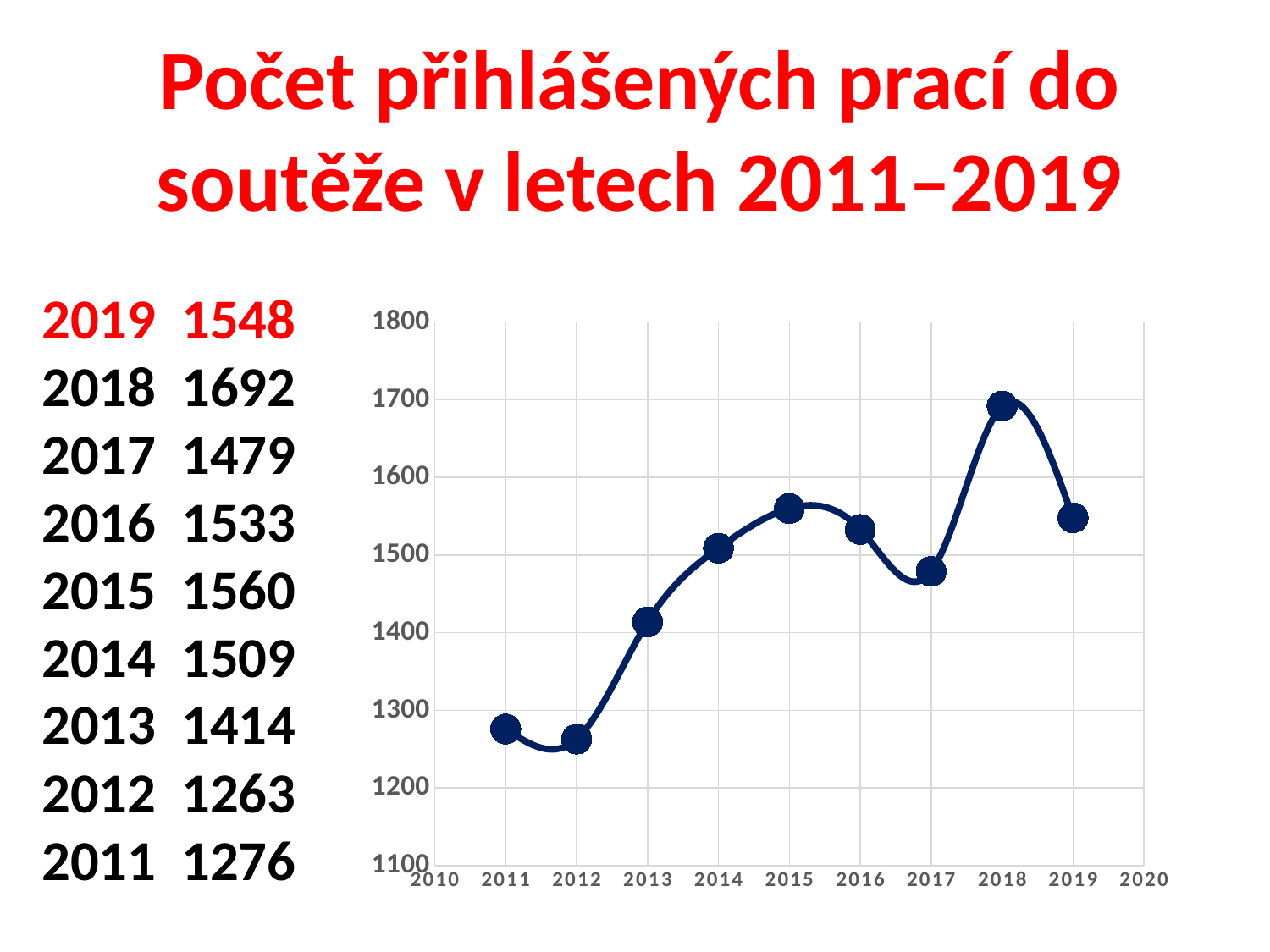
What is the value plotted for 2011? 1276 What is the difference between the values for 2013 and 2012? 151 How many data points are plotted on the chart? 9 Is the value for 2018 greater or less than 1600? greater Is the value for 2013 greater or less than 1500? less Do the values rise or fall from 2012 to 2015? rise What is the title of the slide? Počet přihlášených prací do soutěže v letech 2011–2019 Which year has the larger value, 2015 or 2016? 2015 What is the number of submitted works for 2018? 1692 Which year has the lowest number of submitted works? 2012 Which year has the highest number of submitted works? 2018 By how much did the number of submitted works fall from 2018 to 2019? 144